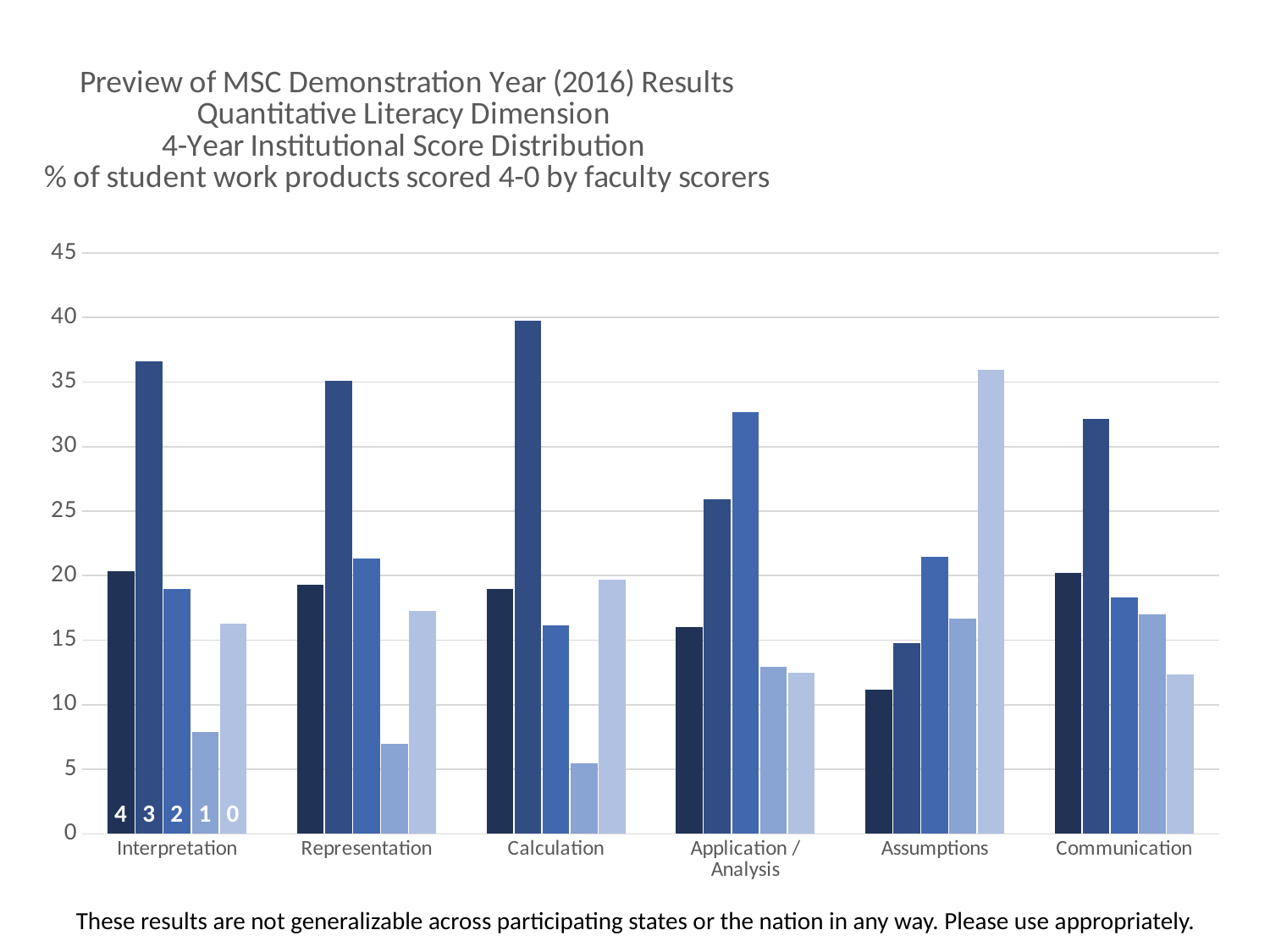
Is the value for score 1 in Representation greater or less than 10? less Is the value for score 4 in Assumptions greater or less than 15? less Is the value for score 3 in Calculation greater or less than 35? greater How many score series (4, 3, 2, 1, 0) are plotted for each category? 5 How many categories are shown along the x axis? 6 In the Assumptions category, which score has the tallest bar? 0 In the Calculation category, which score has the tallest bar? 3 In the Representation category, which score has the shortest bar? 1 In the Calculation category, which score has the shortest bar? 1 Which dimension is named in the second line of the chart title? Quantitative Literacy Dimension What kind of chart is shown on the slide? bar chart In the Application / Analysis category, which is larger: the bar for score 2 or the bar for score 3? score 2